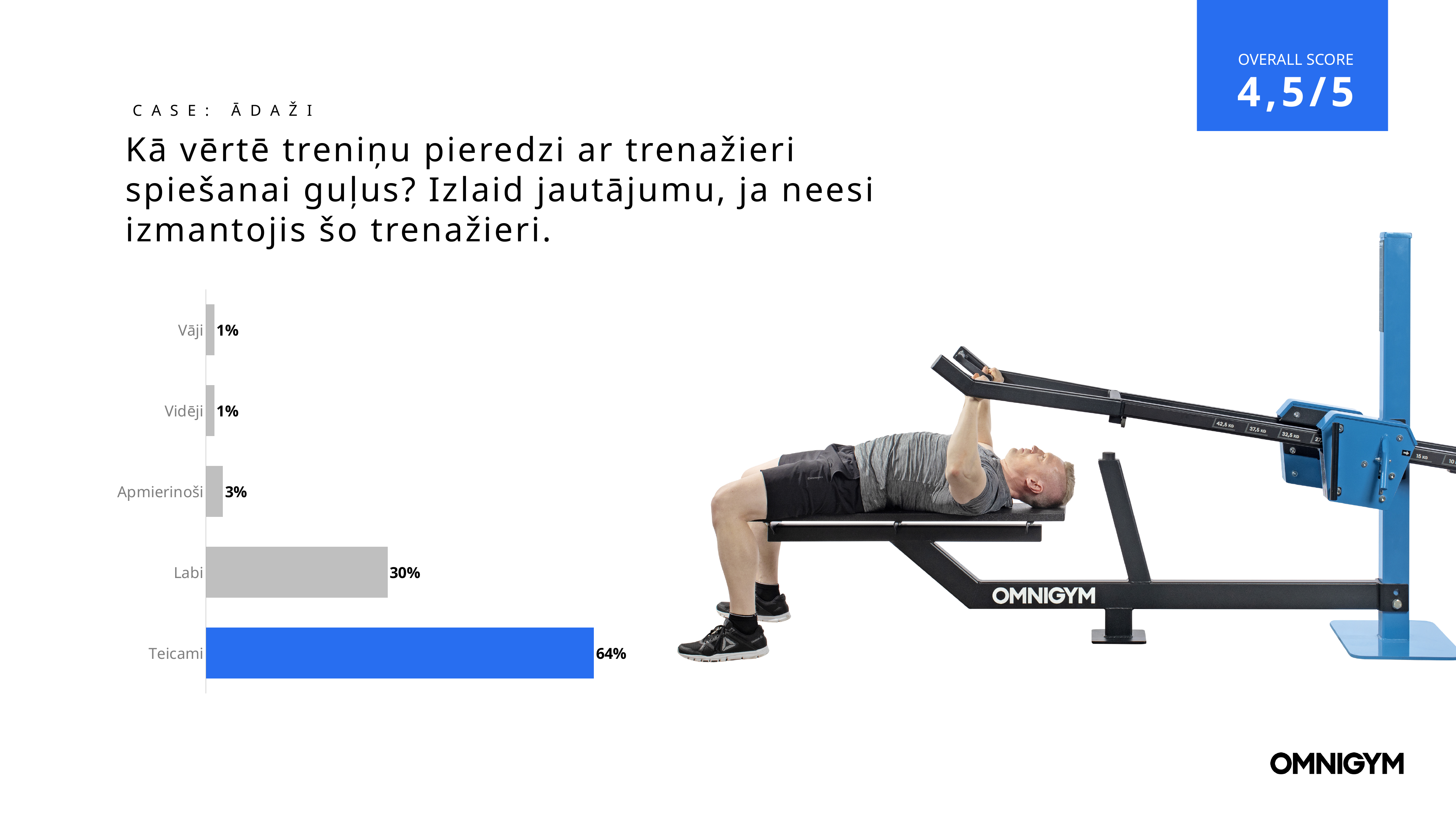
Which bar is coloured blue rather than grey? Teicami What is the value shown for Vāji? 1% What percentage of respondents rated the experience as Teicami? 64% What kind of chart is shown on the slide? Bar chart How many categories are shown in the chart? 5 Which category has the highest value? Teicami What is the value shown for Labi? 30% Which is larger, the value for Labi or the value for Apmierinoši? Labi What is the difference between the values for Labi and Apmierinoši? 27% What is the value shown for Apmierinoši? 3% What is the difference between the values for Teicami and Labi? 34% What is the combined value of Teicami and Labi? 94%